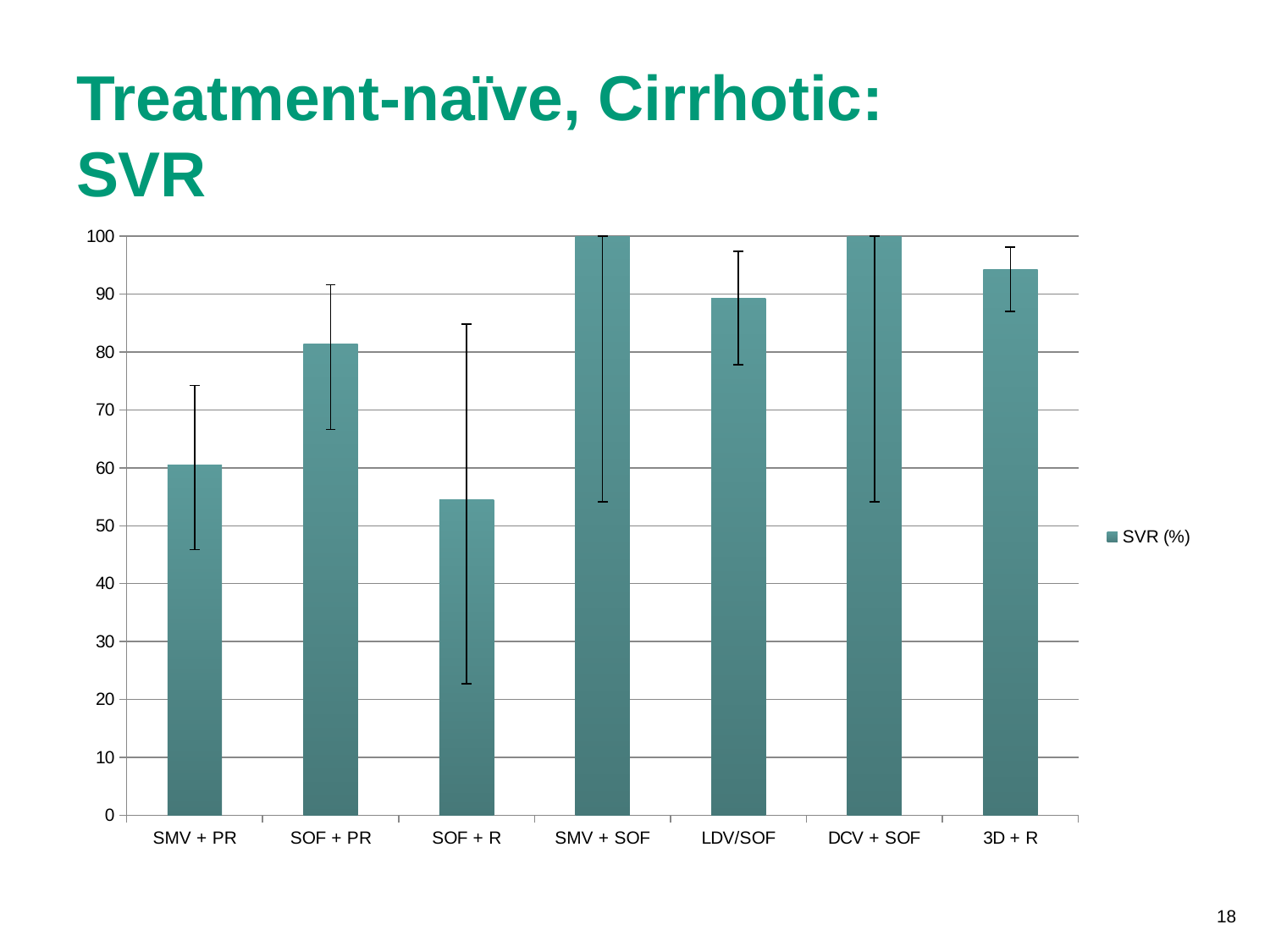
How many treatment categories are shown on the x axis? 7 What is the SVR (%) value for SMV + SOF? 100 Is the SVR (%) value for SOF + PR greater or less than 80? greater Is the SVR (%) value for LDV/SOF greater or less than 80? greater Is the SVR (%) value for 3D + R greater or less than 90? greater What is the series name shown in the legend? SVR (%) What kind of chart is shown on the slide? Bar chart What is the SVR (%) value for DCV + SOF? 100 How many series does the legend list? 1 Which treatment category has the lowest SVR (%)? SOF + R Which has a higher SVR (%), SOF + PR or SMV + PR? SOF + PR